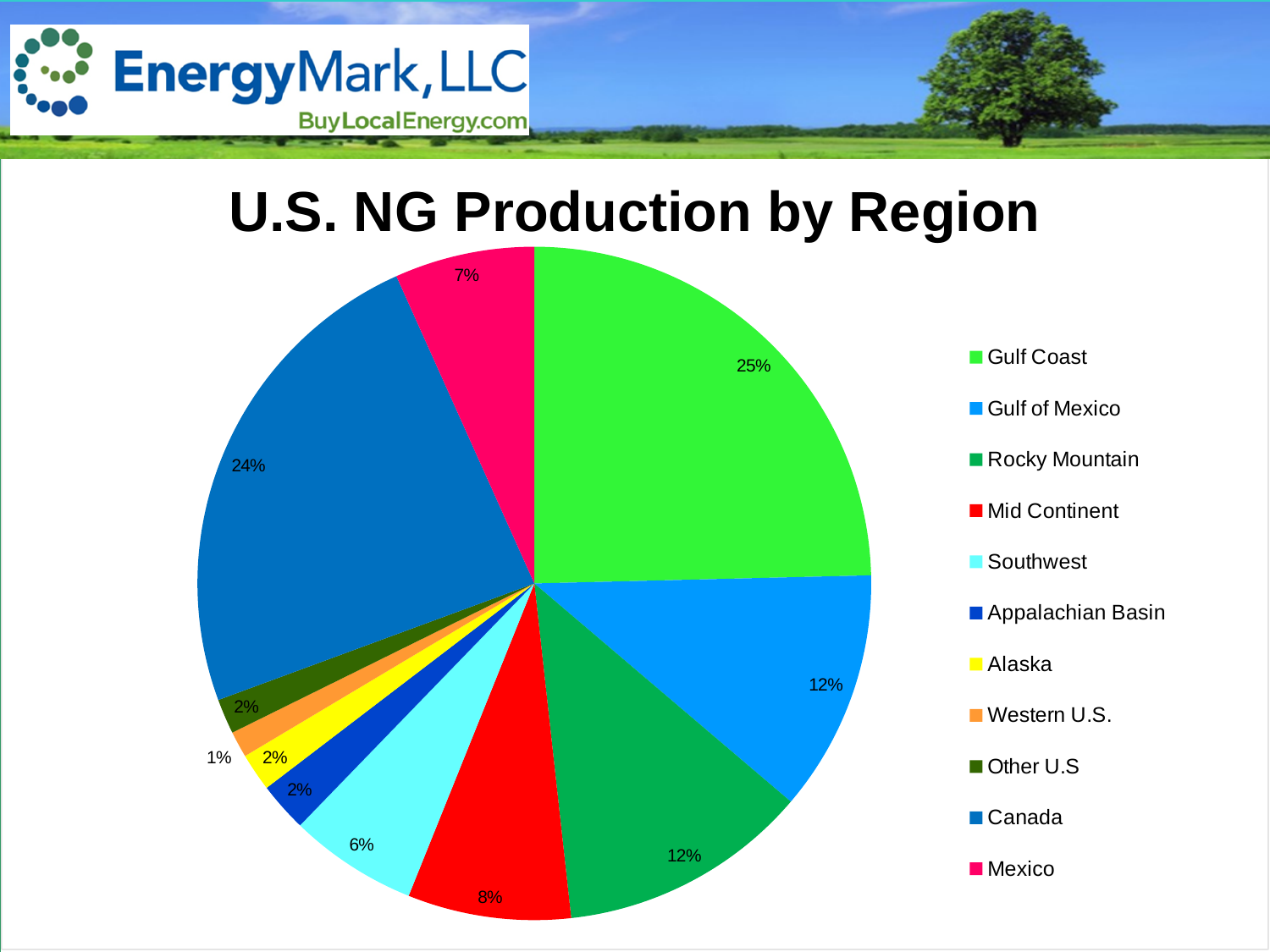
What share of U.S. NG production does the Gulf Coast account for? 25% What share of U.S. NG production does the Mid Continent account for? 8% What is the difference in share between the Gulf Coast and Canada? 1% Which region has the largest share of U.S. NG production? Gulf Coast What share of U.S. NG production does Mexico account for? 7% Which region has the smallest share of U.S. NG production? Western U.S. What is the title of the chart? U.S. NG Production by Region How many regions does the legend list? 11 Which has a larger share, Southwest or Mexico? Mexico What kind of chart is shown on the slide? pie chart